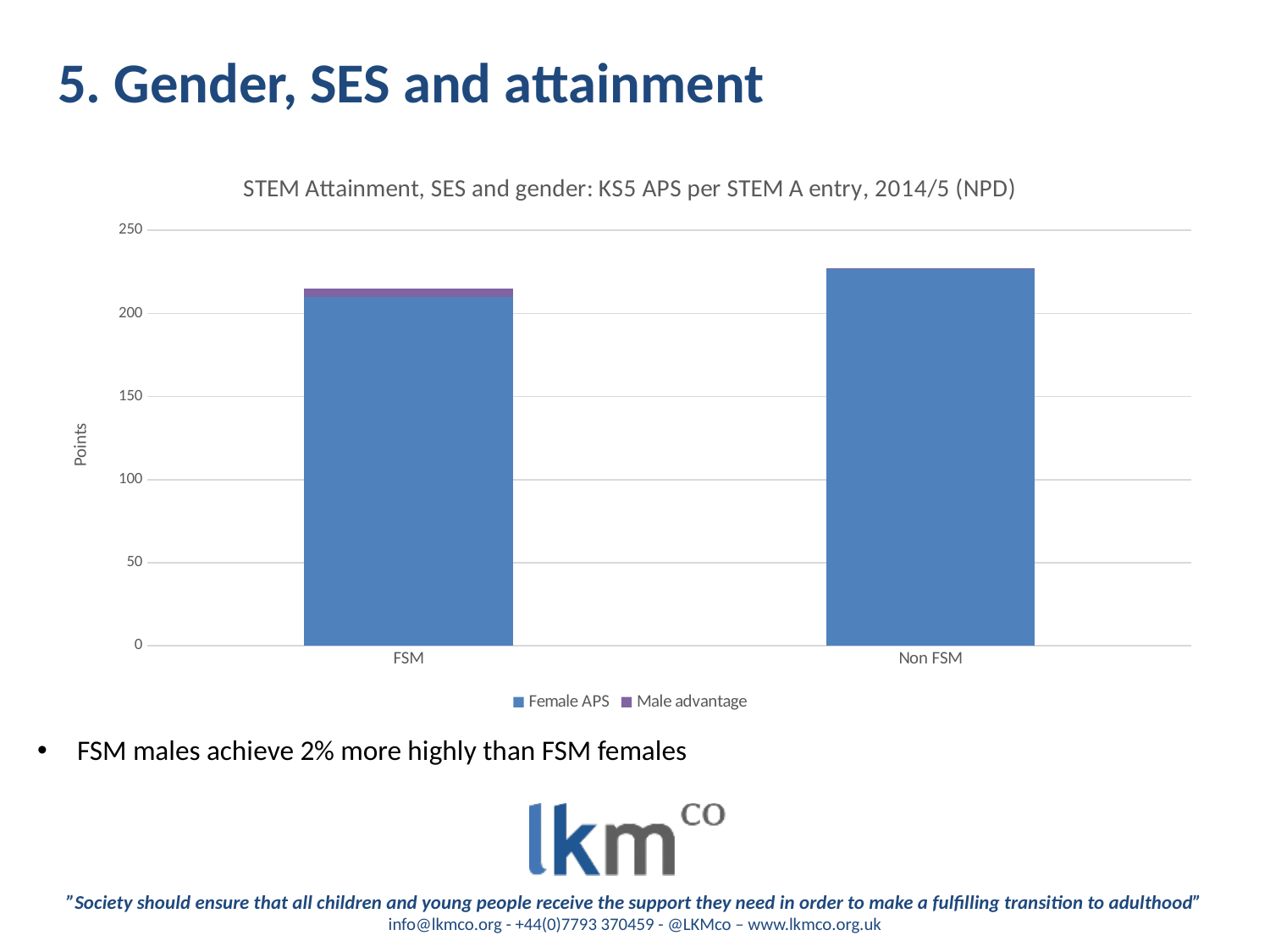
Is the Female APS value for FSM greater or less than 150? greater Which category shows a visible Male advantage segment? FSM Is the Female APS value for FSM greater or less than 250? less How many categories are shown on the x axis of the chart? 2 What kind of chart is shown on the slide? bar chart What is the label on the chart's y axis? Points Which category has the taller bar, FSM or Non FSM? Non FSM Which category has the lowest total bar height? FSM What is the title of the chart? STEM Attainment, SES and gender: KS5 APS per STEM A entry, 2014/5 (NPD) Is the Female APS value for Non FSM greater or less than 200? greater How many series does the chart's legend list? 2